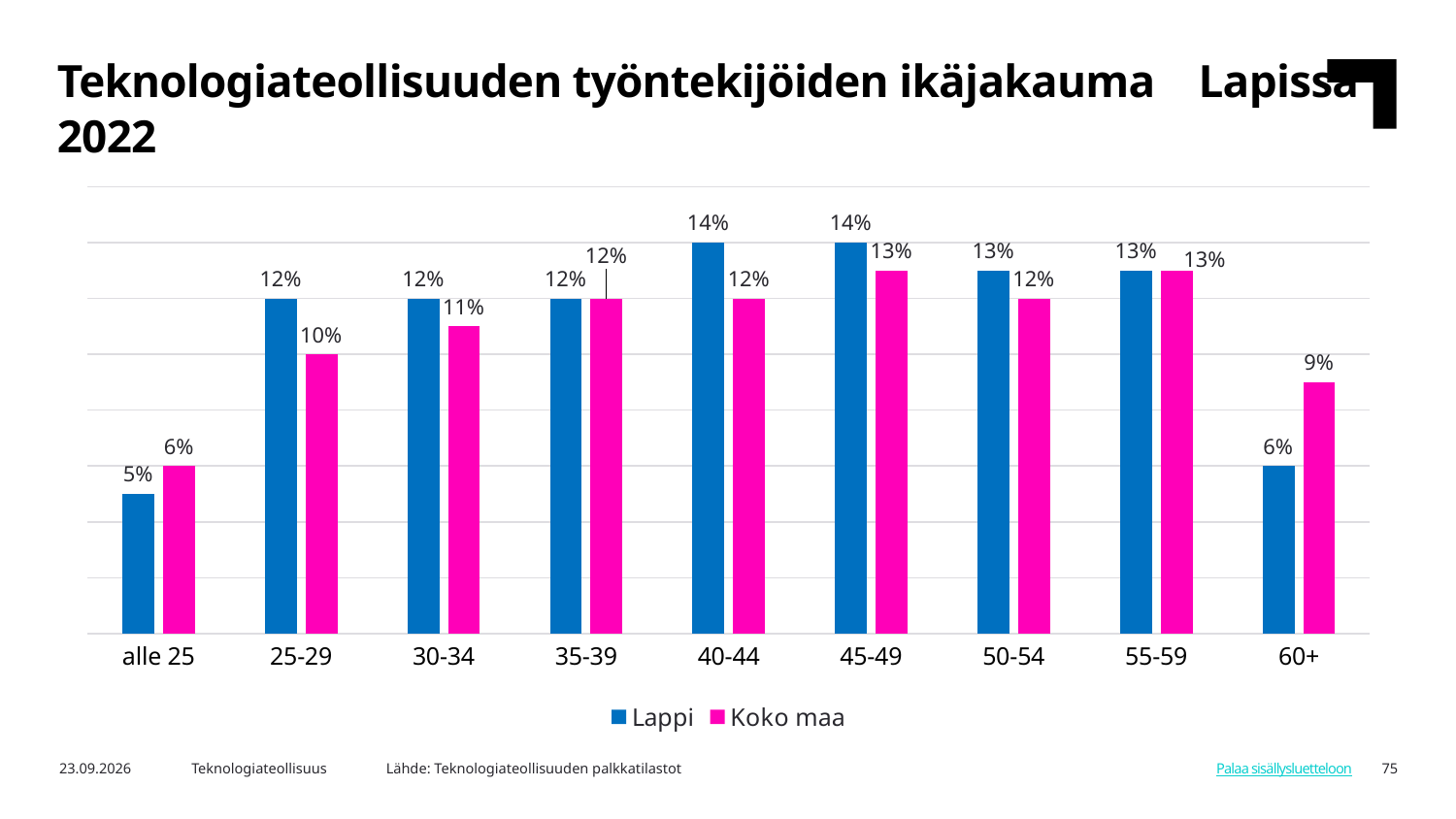
What is the value for Lappi in the 40-44 age group? 14% What is the difference between Lappi and Koko maa in the 60+ age group? 3% Which series is shown in pink? Koko maa What is the value for Koko maa in the 60+ age group? 9% Which is larger in the 60+ age group, Lappi or Koko maa? Koko maa How many age categories are shown on the x axis? 9 Which age group has the lowest value for Lappi? alle 25 What is the value for Koko maa in the 25-29 age group? 10% Which is larger in the 25-29 age group, Lappi or Koko maa? Lappi Which age group has the lowest value for Koko maa? alle 25 How many series does the legend list? 2 What kind of chart is shown on the slide? bar chart